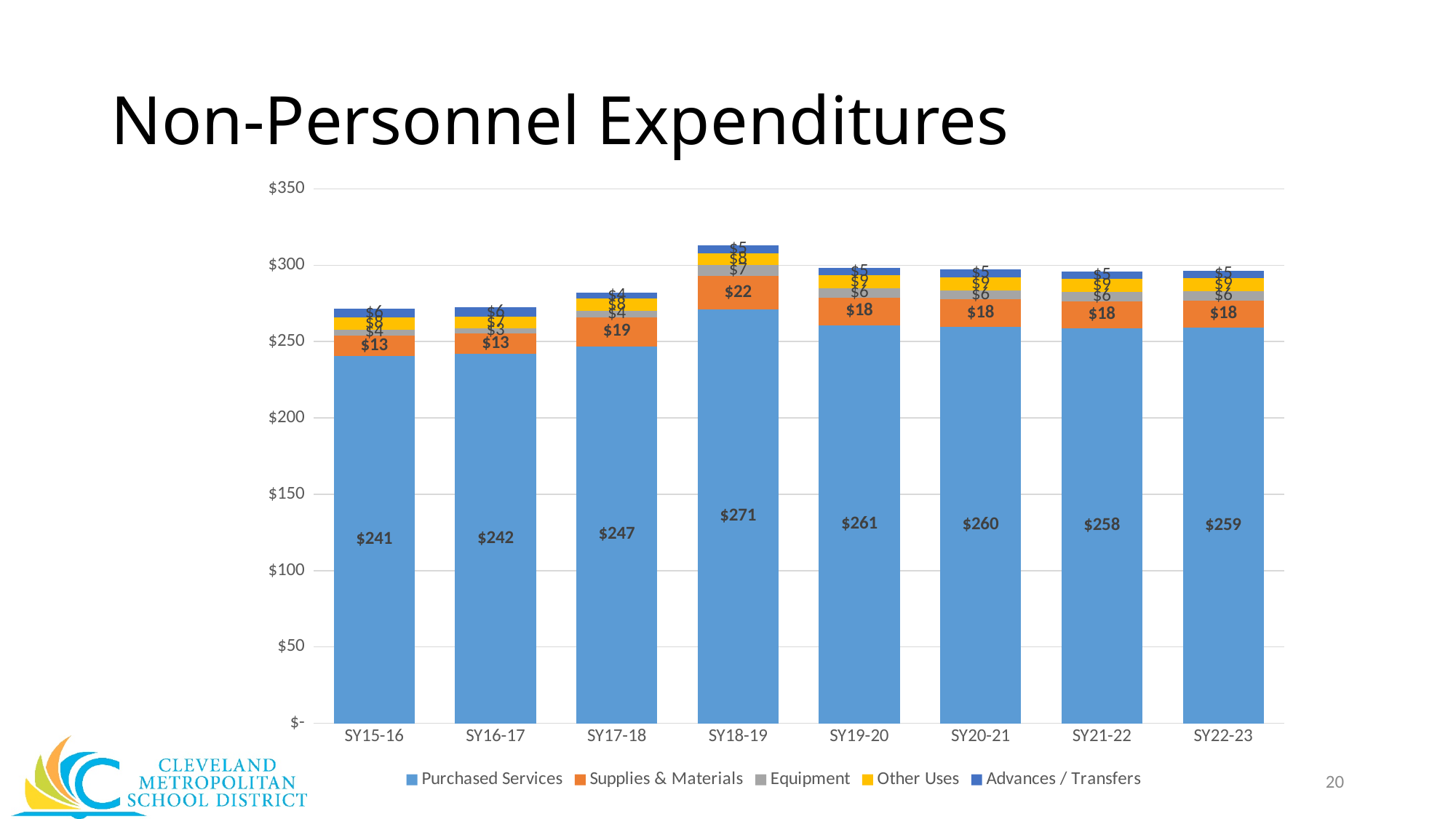
In which school year is Purchased Services highest? SY18-19 What is the title of the slide containing the chart? Non-Personnel Expenditures Which is larger, Purchased Services in SY19-20 or in SY20-21? SY19-20 What is the value for Supplies & Materials in SY17-18? $19 What is the value for Purchased Services in SY18-19? $271 How many series does the legend list? 5 What is the difference between Purchased Services in SY18-19 and SY15-16? $30 What is the value for Supplies & Materials in SY15-16? $13 What kind of chart is shown on the slide? Stacked bar chart In which school year is Purchased Services lowest? SY15-16 How many school years are shown on the x axis? 8 Is the total height of the SY18-19 stacked bar greater or less than $300? greater